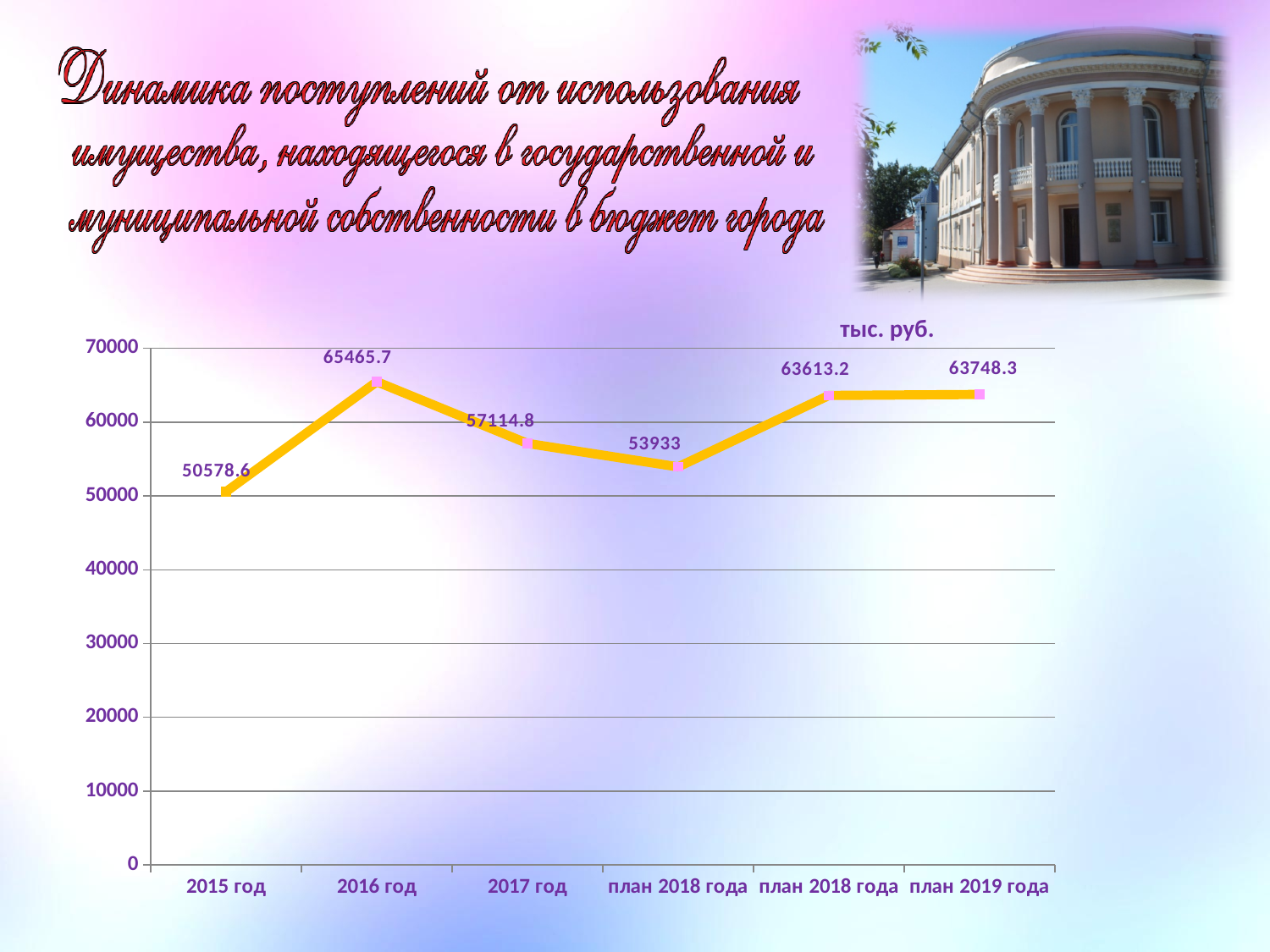
Which category has the lowest value? 2015 год What is the difference between the values for 2016 год and 2015 год? 14887.1 Which category has the highest value? 2016 год What is the value for 2017 год? 57114.8 How many data points are plotted on the chart? 6 What unit is shown above the chart's y axis? тыс. руб. What is the value for 2015 год? 50578.6 Is the value for 2015 год greater or less than 60000? less What is the value for план 2019 года? 63748.3 Which is larger, the value for 2016 год or the value for 2017 год? 2016 год What type of chart is shown on the slide? line chart What is the value for 2016 год? 65465.7